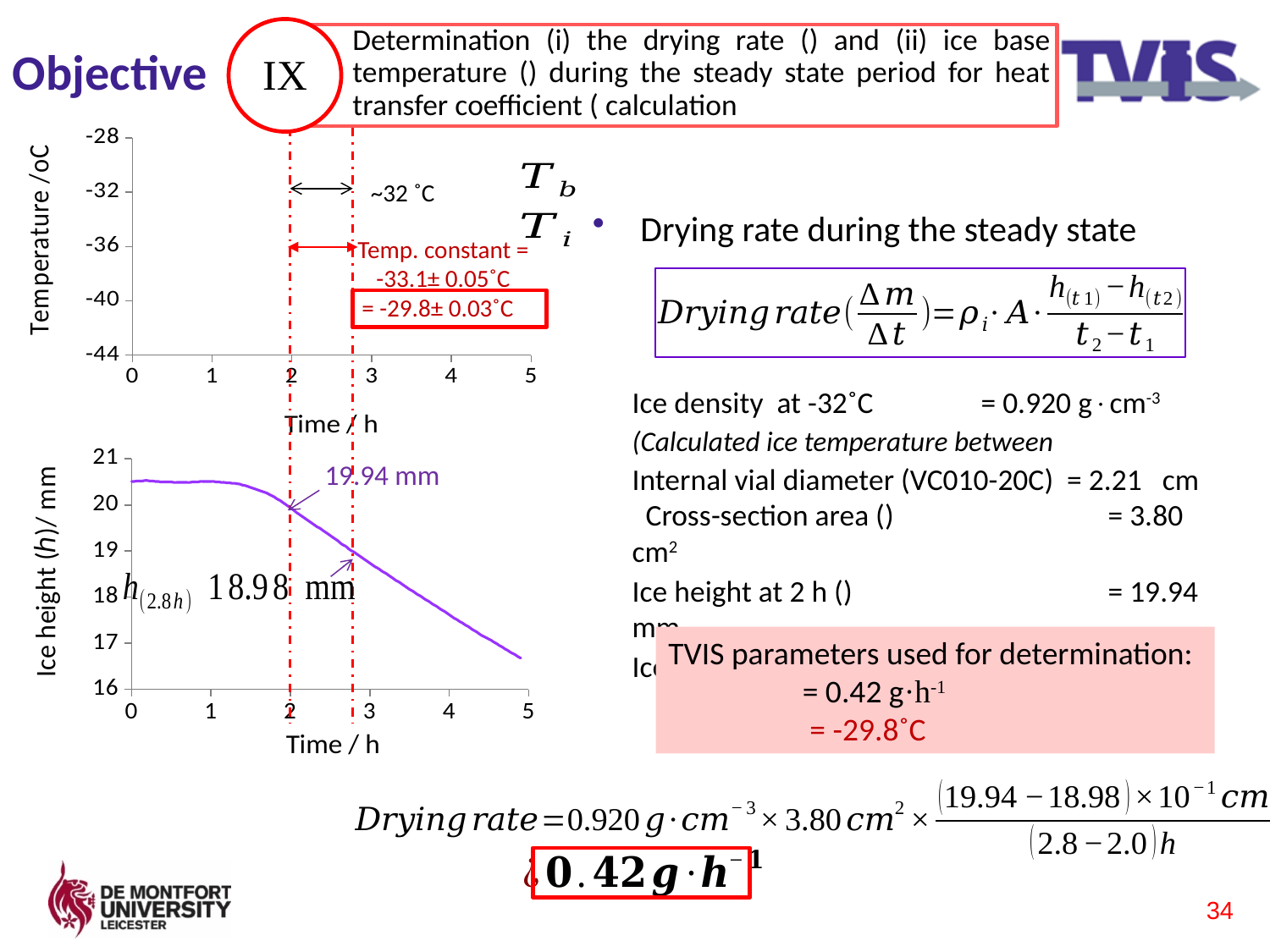
In the bottom chart (Ice height vs Time), what is the labelled ice height at 2 h? 19.94 mm What is the x-axis label of the bottom chart (Ice height vs Time)? Time / h In the bottom chart (Ice height vs Time), is the ice height at 4 h greater or less than 18? less What kind of chart is the bottom chart (Ice height vs Time)? line chart In the bottom chart (Ice height vs Time), which is larger: the labelled ice height at 2 h or at 2.8 h? 2 h In the bottom chart (Ice height vs Time), what is the difference between the labelled ice heights at 2 h and 2.8 h? 0.96 mm What is the y-axis label of the top chart? Temperature /oC In the bottom chart (Ice height vs Time), is the ice height at 1 h greater or less than 20? greater In the bottom chart (Ice height vs Time), is the ice height at 0 h greater or less than 20? greater In the bottom chart (Ice height vs Time), what is the labelled ice height at 2.8 h? 18.98 mm In the bottom chart (Ice height vs Time), does the ice height rise or fall as time increases? fall